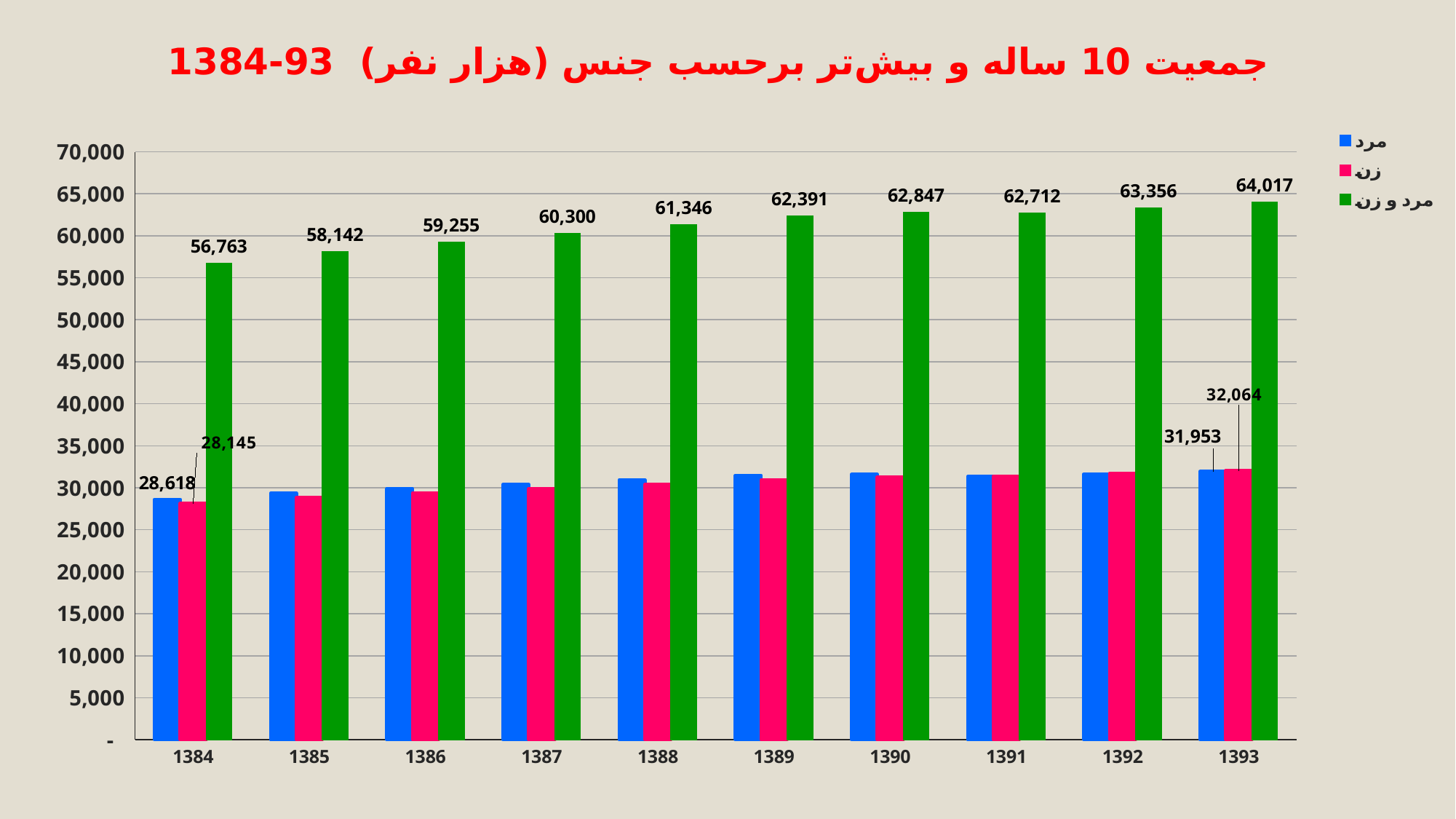
In which year is the مرد و زن (green) series highest? 1393 What is the difference between the مرد و زن values for 1393 and 1384? 7,254 How many series does the legend list? 3 What is the value of the مرد و زن (green) series for 1384? 56,763 Is the value of the مرد (blue) series for 1390 greater or less than 30,000? greater What is the value of the مرد (blue) series for 1384? 28,618 What is the value of the زن (pink) series for 1393? 32,064 In which year is the مرد و زن (green) series lowest? 1384 What is the value of the مرد و زن (green) series for 1393? 64,017 What kind of chart is shown on the slide? bar chart Which is larger for 1393, the مرد value or the زن value? زن (32,064) How many years are shown on the x axis? 10